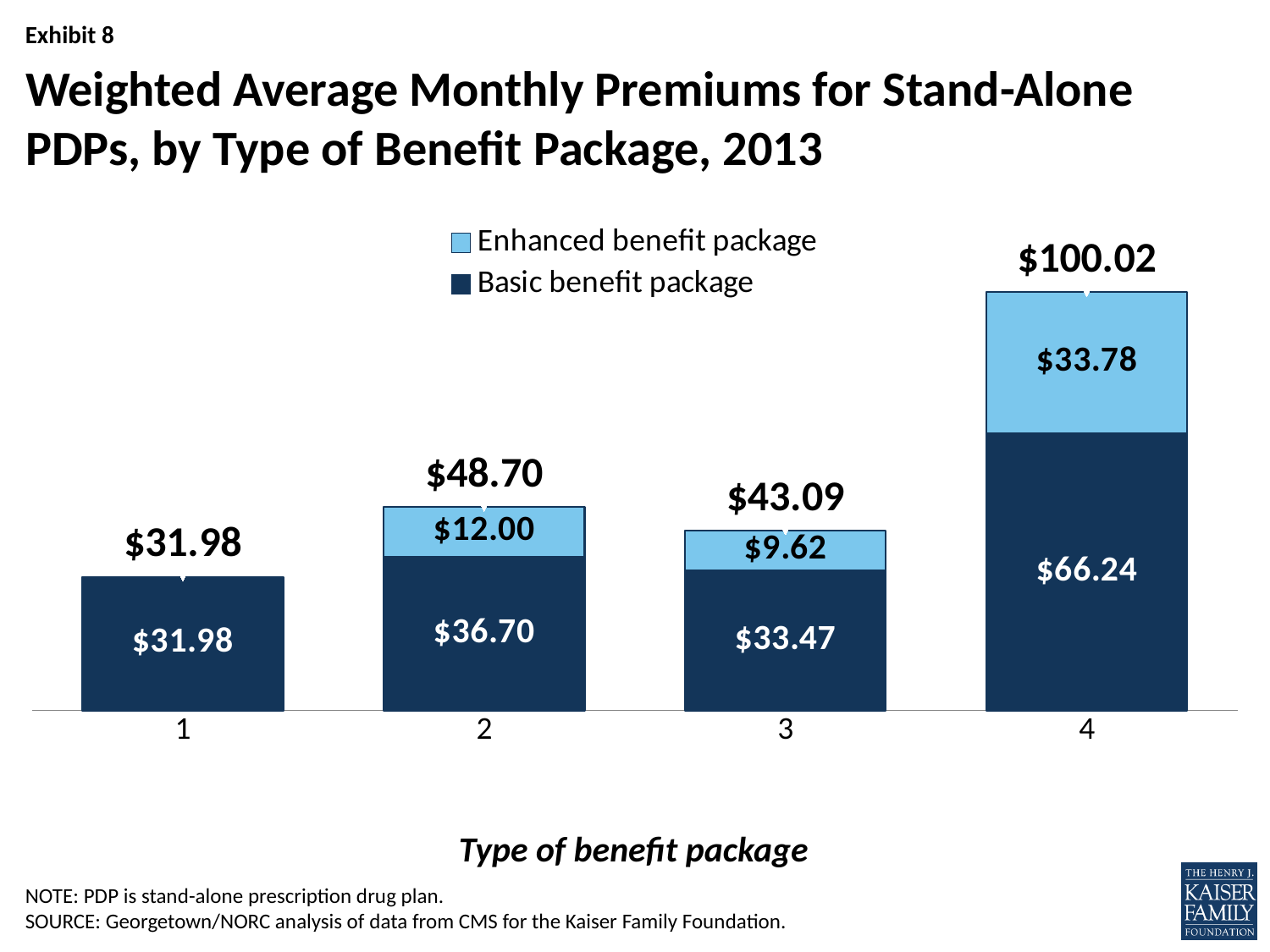
What is the Enhanced benefit package value for category 4? $33.78 What is the Basic benefit package value for category 2? $36.70 Which is larger, the Enhanced benefit package value for category 2 or for category 3? Category 2 What is the total of the stacked bar for category 4? $100.02 How many categories are shown on the x axis? 4 Which category has the highest total monthly premium? 4 What is the difference between the Basic benefit package values for category 4 and category 1? $34.26 What kind of chart is shown on the slide? Stacked bar chart How many series does the legend list? 2 What is the Enhanced benefit package value for category 3? $9.62 Which category has the lowest total monthly premium? 1 What is the total of the stacked bar for category 2? $48.70